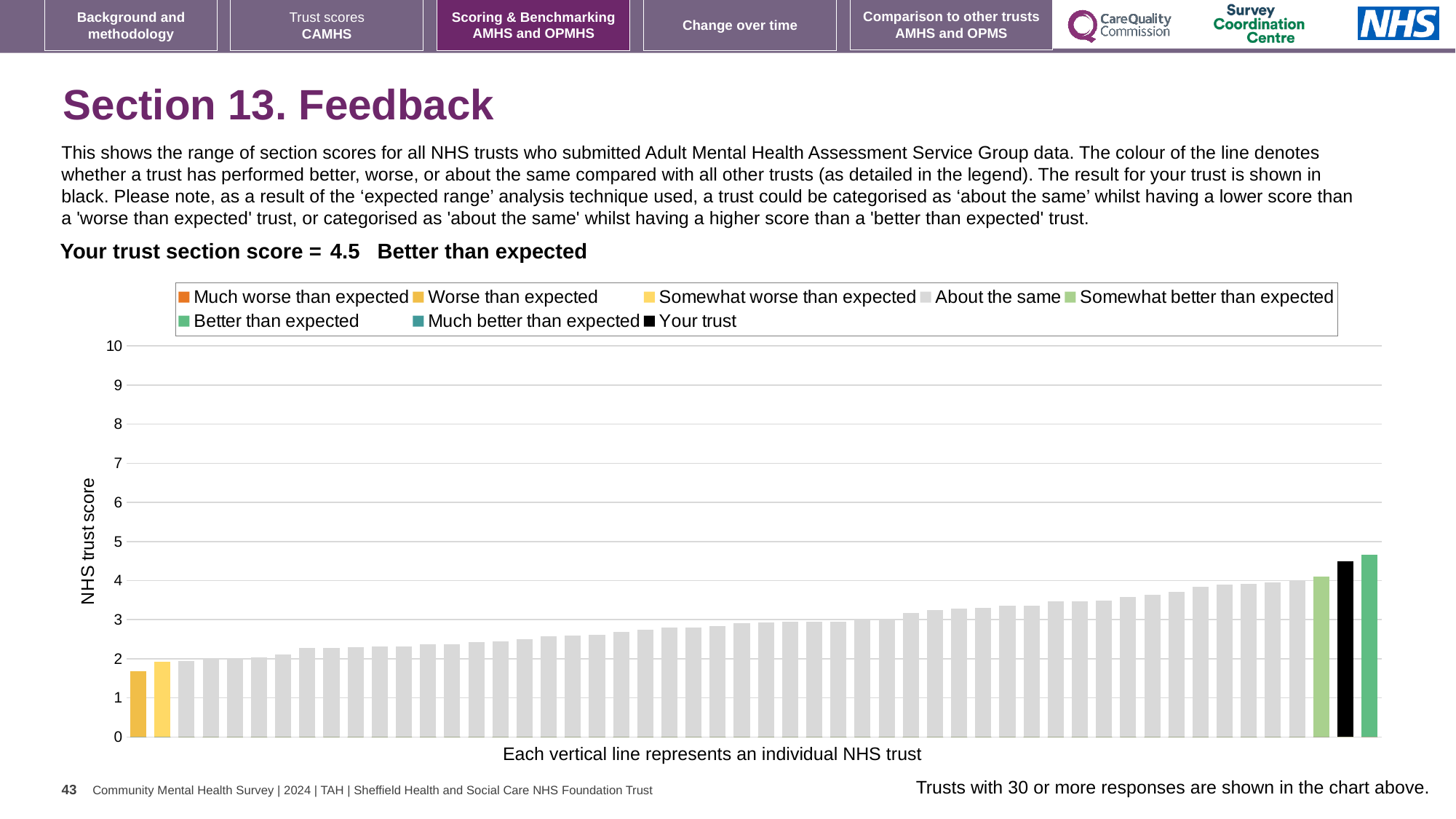
Is the value of the tallest grey 'About the same' bar greater or less than 5? less What is the label on the vertical axis of the chart? NHS trust score Is the value of the black 'Your trust' bar greater or less than 4? greater Which is larger: the value of the leftmost bar or the value of the black 'Your trust' bar? The black 'Your trust' bar Do the bar values rise or fall from left to right along the x axis? Rise What is the section score for your trust shown on the slide? 4.5 According to the slide, how is your trust's section score categorised? Better than expected Which legend category does the lowest bar in the chart belong to? Worse than expected Is the value of the leftmost bar greater or less than 2? less What kind of chart is shown on the slide? Bar chart How many entries does the chart legend list? 8